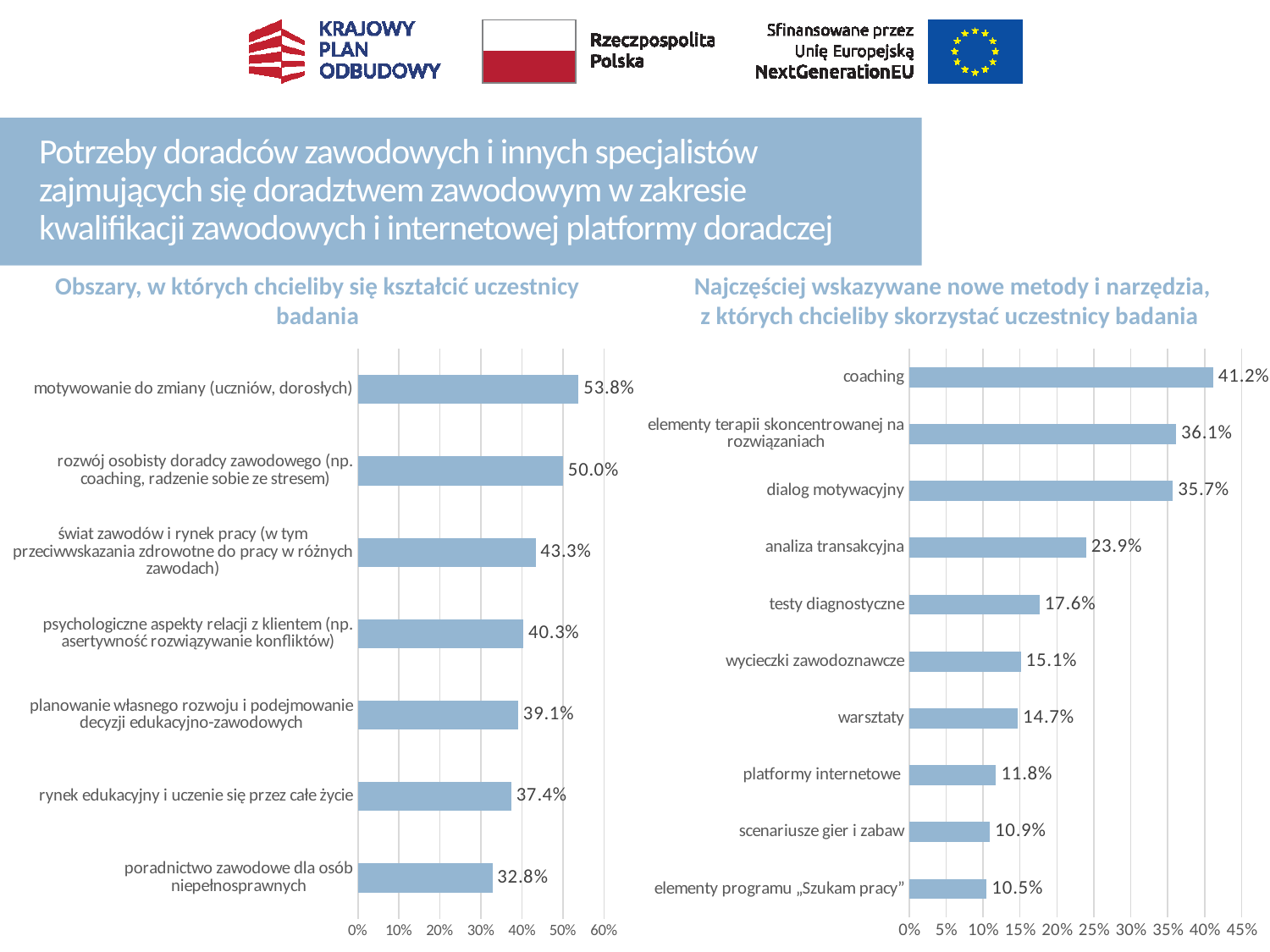
In the right chart (Najczęściej wskazywane nowe metody i narzędzia), which is larger: "analiza transakcyjna" or "wycieczki zawodoznawcze"? analiza transakcyjna In the right chart (Najczęściej wskazywane nowe metody i narzędzia), which category has the lowest value? elementy programu „Szukam pracy” In the left chart (Obszary, w których chcieliby się kształcić uczestnicy badania), which category has the highest value? motywowanie do zmiany (uczniów, dorosłych) In the right chart (Najczęściej wskazywane nowe metody i narzędzia), what is the difference between "coaching" and "dialog motywacyjny"? 5.5% In the left chart (Obszary, w których chcieliby się kształcić uczestnicy badania), what kind of chart is used? bar chart In the right chart (Najczęściej wskazywane nowe metody i narzędzia), what is the value for "coaching"? 41.2% In the left chart (Obszary, w których chcieliby się kształcić uczestnicy badania), what is the difference between "rozwój osobisty doradcy zawodowego" and "rynek edukacyjny i uczenie się przez całe życie"? 12.6% In the left chart (Obszary, w których chcieliby się kształcić uczestnicy badania), what is the value for "motywowanie do zmiany (uczniów, dorosłych)"? 53.8% In the left chart (Obszary, w których chcieliby się kształcić uczestnicy badania), how many categories are shown? 7 In the right chart (Najczęściej wskazywane nowe metody i narzędzia), how many categories are shown? 10 In the left chart (Obszary, w których chcieliby się kształcić uczestnicy badania), what is the value for "poradnictwo zawodowe dla osób niepełnosprawnych"? 32.8% In the right chart (Najczęściej wskazywane nowe metody i narzędzia), what is the value for "testy diagnostyczne"? 17.6%